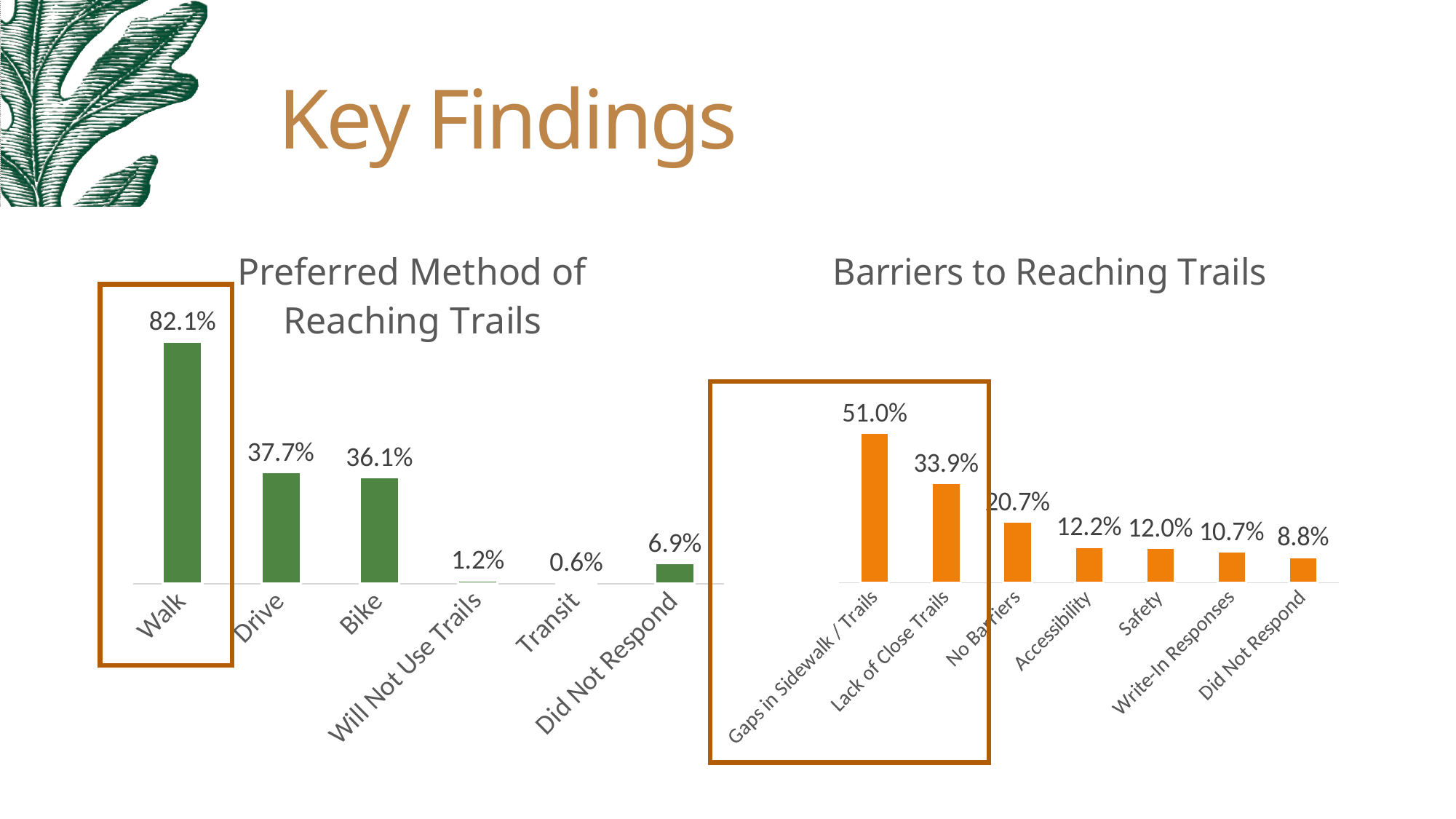
What kind of chart is the 'Barriers to Reaching Trails' chart? Bar chart In the 'Barriers to Reaching Trails' chart, what is the value for No Barriers? 20.7% In the 'Barriers to Reaching Trails' chart, which category has the highest value? Gaps in Sidewalk / Trails What colour are the bars in the 'Preferred Method of Reaching Trails' chart? Green In the 'Barriers to Reaching Trails' chart, which is larger: Safety or Write-In Responses? Safety In the 'Preferred Method of Reaching Trails' chart, which category has the lowest value? Transit In the 'Preferred Method of Reaching Trails' chart, how many categories are shown? 6 In the 'Preferred Method of Reaching Trails' chart, what is the value for Did Not Respond? 6.9% In the 'Barriers to Reaching Trails' chart, what is the difference between Gaps in Sidewalk / Trails and Lack of Close Trails? 17.1% In the 'Barriers to Reaching Trails' chart, how many categories are shown? 7 In the 'Preferred Method of Reaching Trails' chart, what is the value for Walk? 82.1% In the 'Preferred Method of Reaching Trails' chart, what is the difference between Drive and Bike? 1.6%